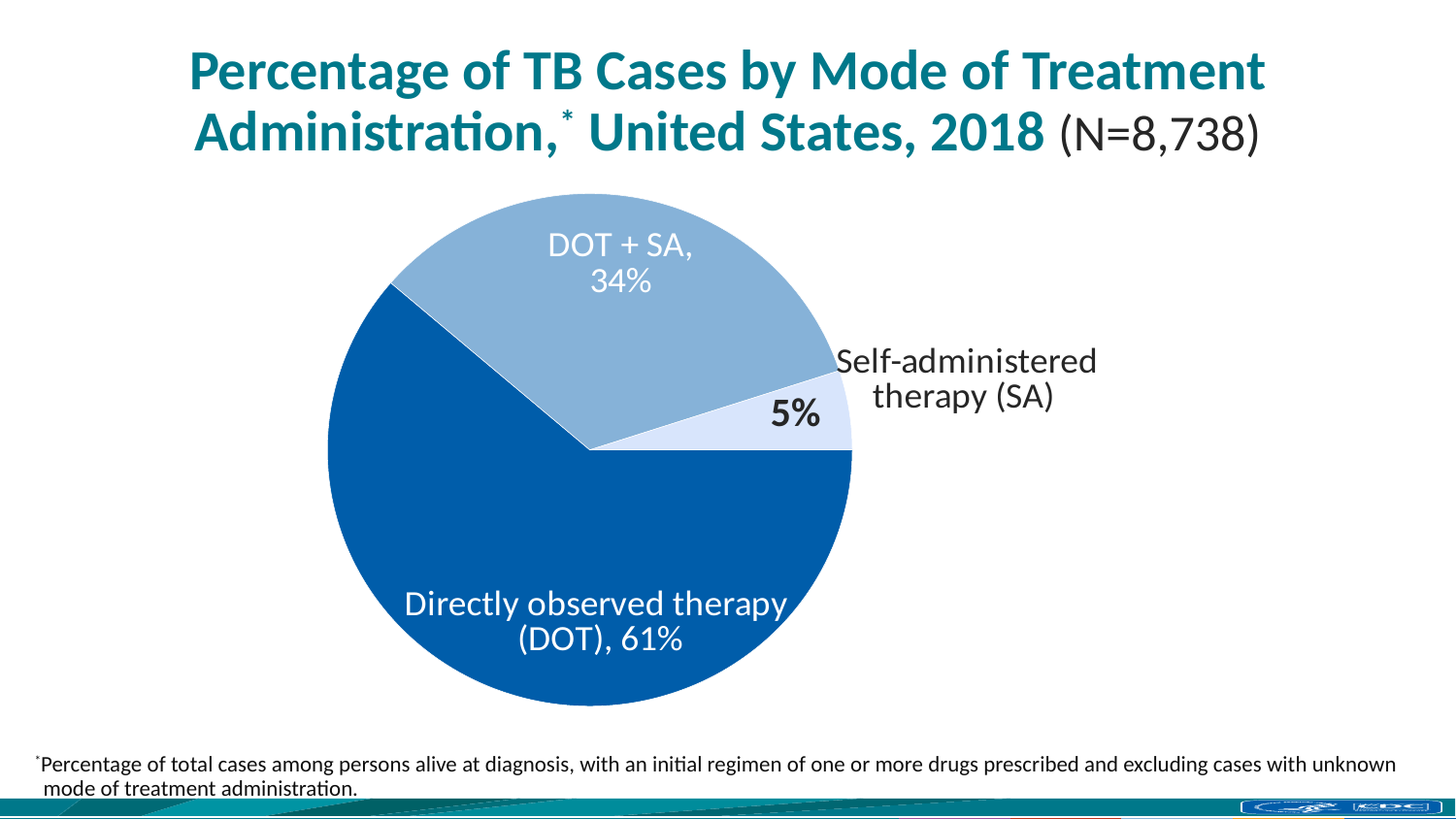
What percentage of TB cases were treated by self-administered therapy (SA)? 5% What percentage of TB cases were treated by directly observed therapy (DOT)? 61% What kind of chart is shown on the slide? Pie chart Which mode of treatment administration has the largest share of TB cases? Directly observed therapy (DOT) What is the total number of cases (N) given in the chart title? 8,738 Which mode of treatment administration has the smallest share of TB cases? Self-administered therapy (SA) What is the difference in percentage points between DOT + SA and self-administered therapy (SA)? 29 How many modes of treatment administration are shown in the pie chart? 3 What is the difference in percentage points between DOT and DOT + SA? 27 Which year does the chart cover? 2018 Which is larger, the share for DOT + SA or the share for self-administered therapy (SA)? DOT + SA What percentage of TB cases were treated by DOT + SA? 34%